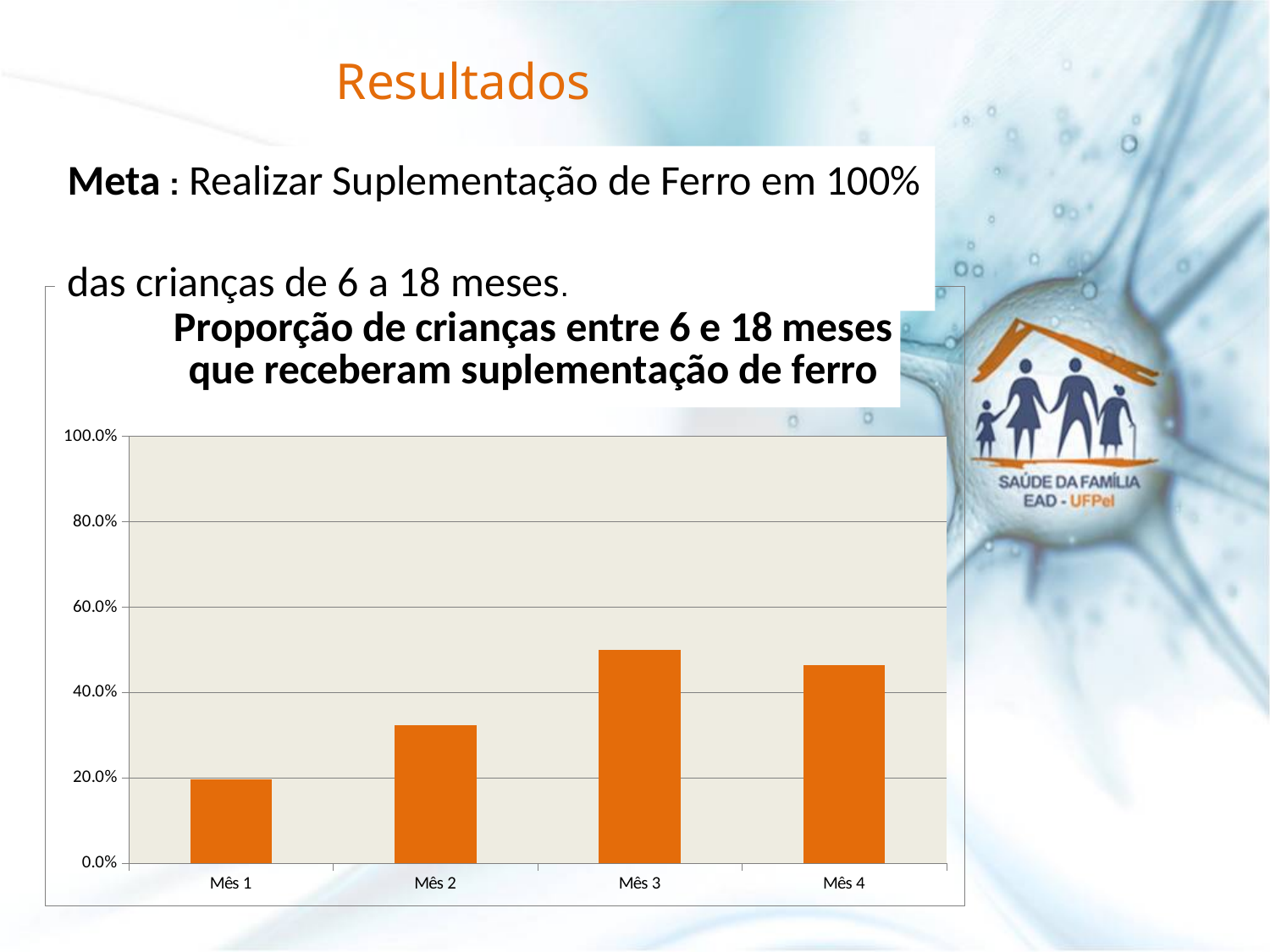
Do the values rise or fall from Mês 1 to Mês 3? rise Is the value for Mês 3 greater or less than 60.0%? less Which month has the highest proportion of children who received iron supplementation? Mês 3 What kind of chart is shown on the slide? bar chart What is the title of the chart? Proporção de crianças entre 6 e 18 meses que receberam suplementação de ferro Is the value for Mês 4 greater or less than 40.0%? greater How many months (categories) are shown on the x axis of the chart? 4 Is the value for Mês 2 greater or less than 40.0%? less Which is larger, the value for Mês 2 or the value for Mês 4? Mês 4 Which is larger, the value for Mês 1 or the value for Mês 3? Mês 3 Which month has the lowest proportion of children who received iron supplementation? Mês 1